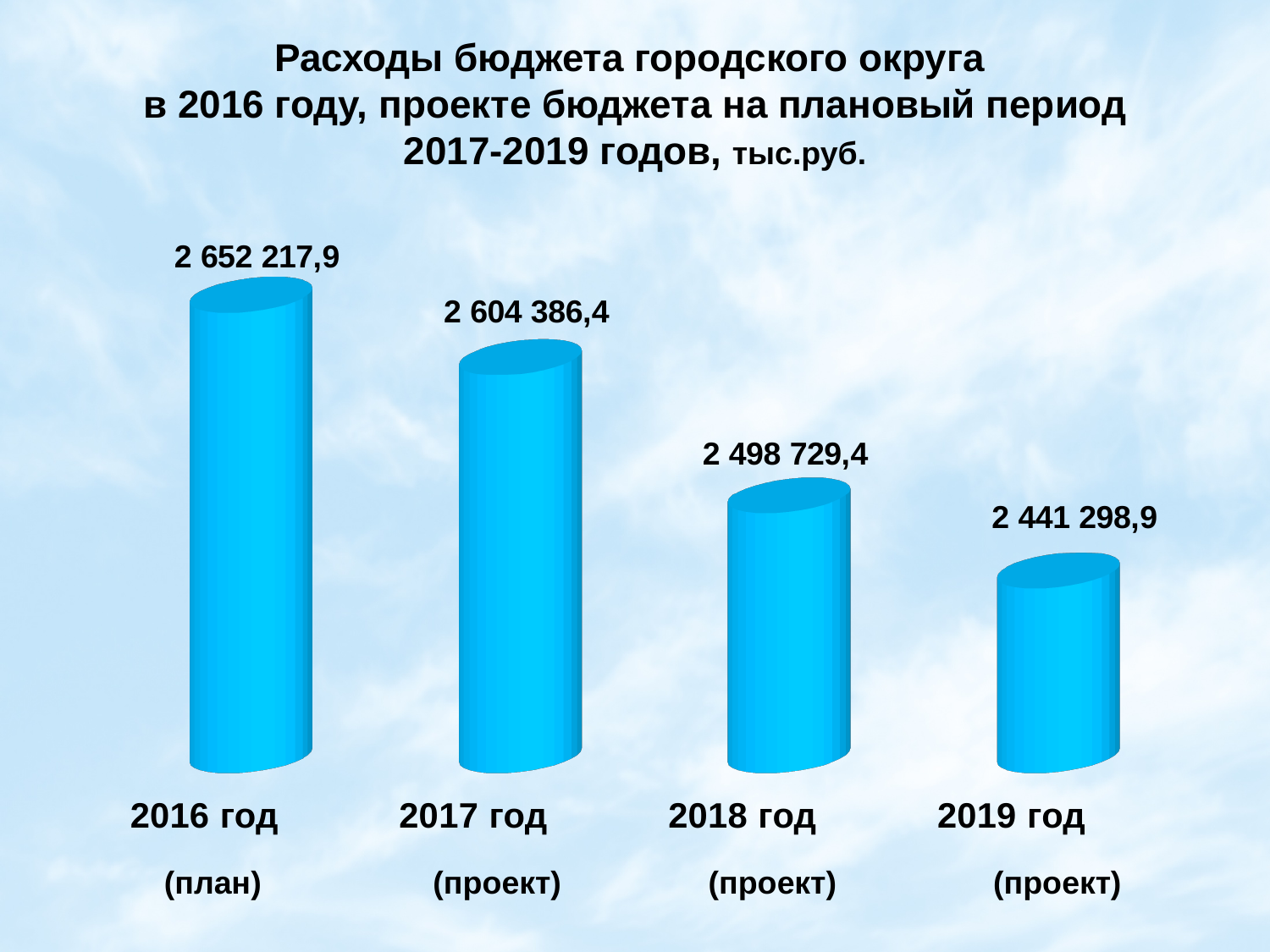
What is the difference between the 2017 and 2018 values? 105 657,0 Which year has the highest budget expenditure on the chart? 2016 год How many years (bars) are shown on the chart? 4 What is the budget expenditure value shown for 2017 год (проект)? 2 604 386,4 What is the difference between the 2016 and 2017 values? 47 831,5 What kind of chart is shown on the slide? Bar chart What is the budget expenditure value shown for 2016 год (план)? 2 652 217,9 What is the difference between the 2016 and 2019 values? 210 919,0 What is the budget expenditure value shown for 2019 год (проект)? 2 441 298,9 Which year has the lowest budget expenditure on the chart? 2019 год What is the budget expenditure value shown for 2018 год (проект)? 2 498 729,4 Which is larger, the value for 2018 год or the value for 2019 год? 2018 год